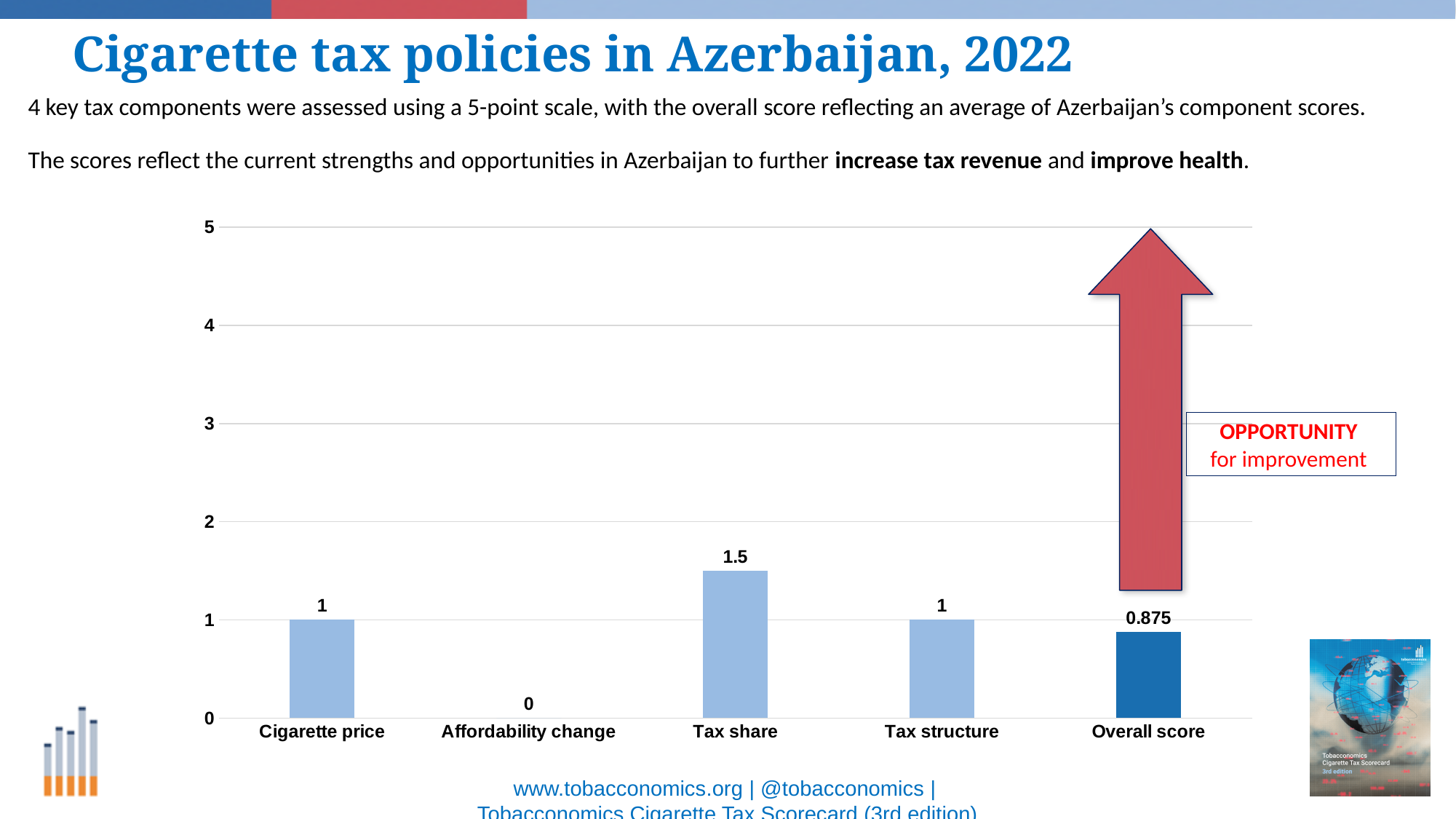
Which category has the highest value? Tax share What is the difference between the values for Tax share and Tax structure? 0.5 What is the value for Tax share? 1.5 Which is larger, the value for Cigarette price or the value for Overall score? Cigarette price What is the highest value shown on the y axis? 5 What is the value for Cigarette price? 1 What is the value for Overall score? 0.875 What kind of chart is shown on the slide? bar chart What is the value for Affordability change? 0 Is the value for Tax share greater or less than 2? less Which category has the lowest value? Affordability change How many categories are shown on the x axis? 5